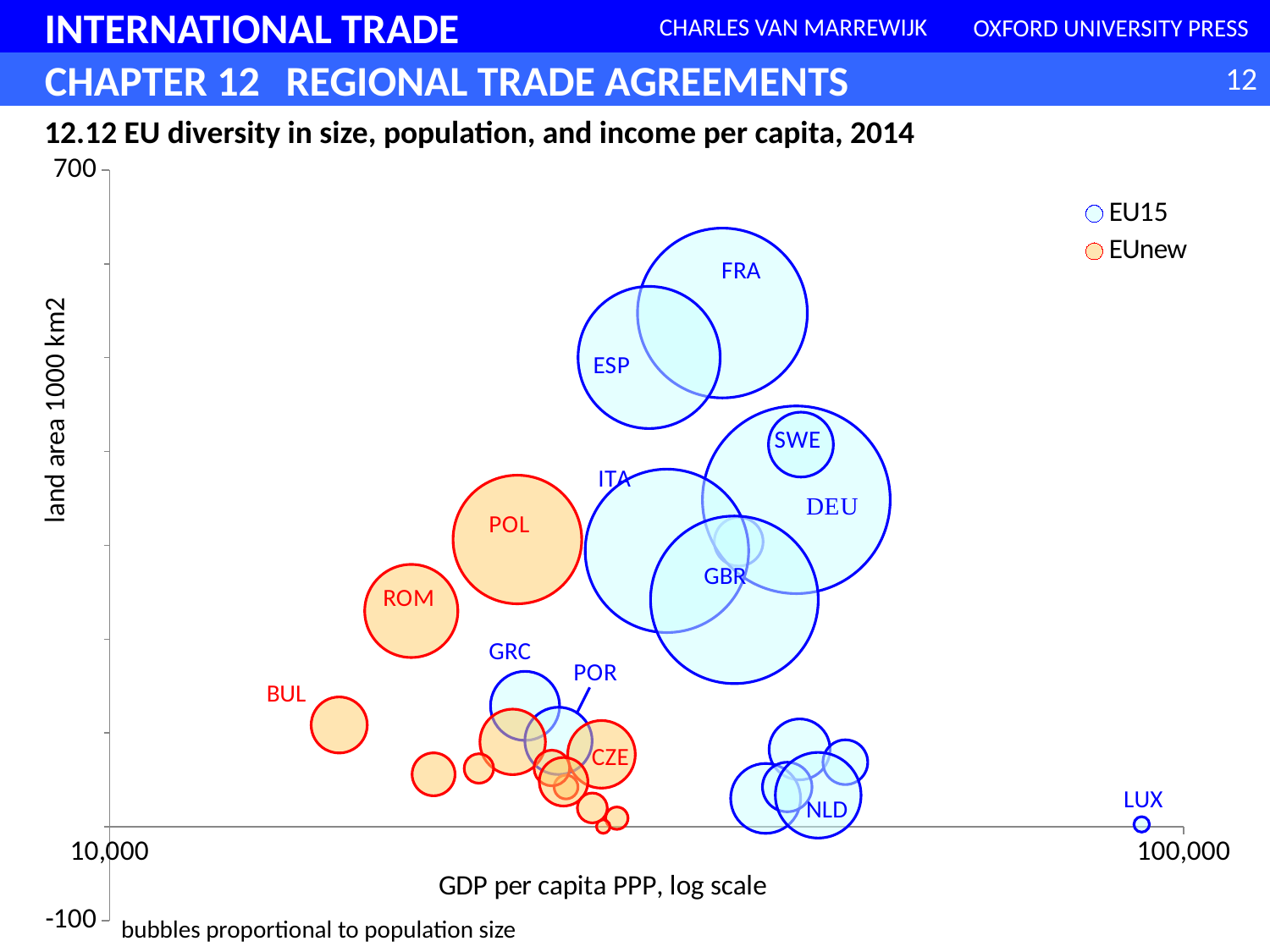
Which labeled country has the smallest land area? LUX How many series does the legend list? 2 Which has the larger land area, POL or ROM? POL Which labeled country has the highest GDP per capita? LUX Which labeled country has the largest land area? FRA Which has the larger land area, FRA or ESP? FRA What are the two series named in the legend? EU15 and EUnew Which labeled country has the lowest GDP per capita? BUL What is the title of the chart? 12.12 EU diversity in size, population, and income per capita, 2014 What kind of chart is shown on the slide? bubble chart Which has the higher GDP per capita, DEU or POL? DEU Is the land area for FRA greater or less than 700? less